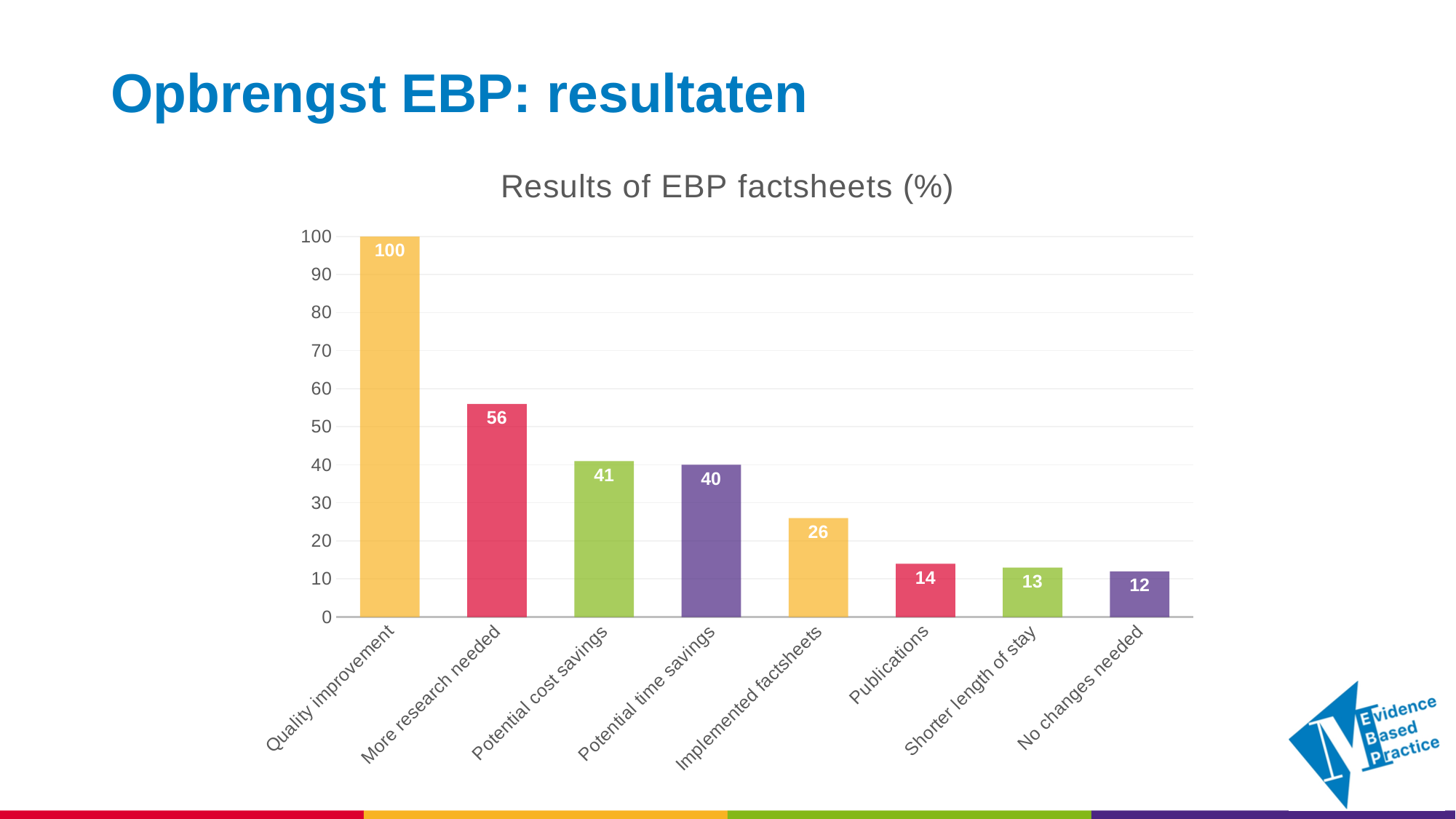
What kind of chart is shown on the slide? bar chart What is the difference between the values for More research needed and Potential cost savings? 15 What is the value for Shorter length of stay? 13 How many categories are shown in the chart? 8 What is the value for Implemented factsheets? 26 Which is larger, the value for Potential time savings or the value for Implemented factsheets? Potential time savings Which category has the highest value? Quality improvement What is the value for More research needed? 56 What is the value for Quality improvement? 100 Which category has the lowest value? No changes needed What is the title of the chart? Results of EBP factsheets (%) Is the value for Publications greater or less than 20? less